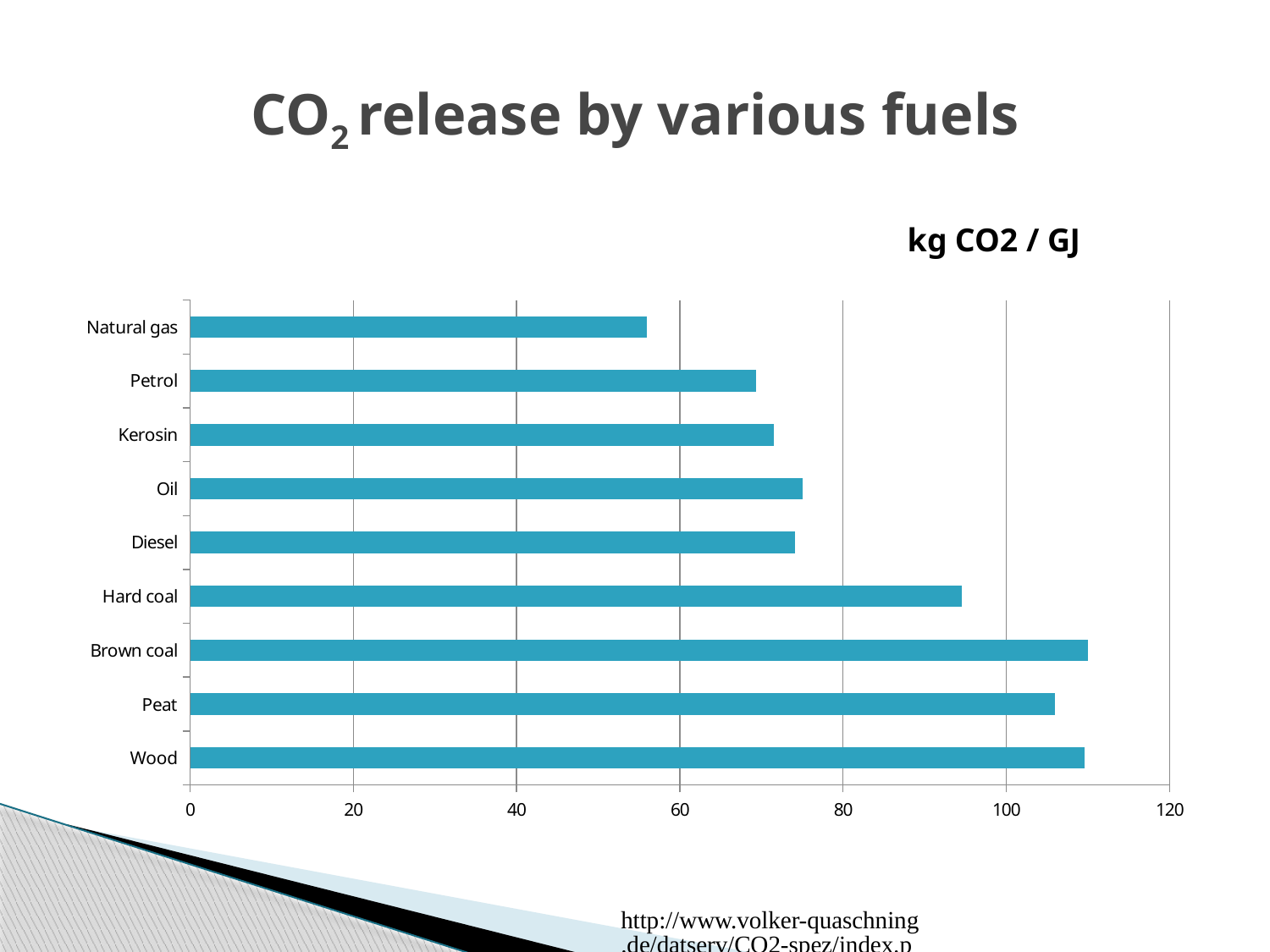
Is the value for Petrol greater or less than 80? less Which fuel has the lowest CO2 release in the chart? Natural gas Is the value for Brown coal greater or less than 100? greater What is the title of the chart on the slide? CO2 release by various fuels Is the value for Peat greater or less than 100? greater What unit is shown for the values in the chart? kg CO2 / GJ Which has a higher CO2 release, Natural gas or Kerosin? Kerosin Which has a higher CO2 release, Hard coal or Diesel? Hard coal What kind of chart is shown on the slide? bar chart How many fuels are plotted in the chart? 9